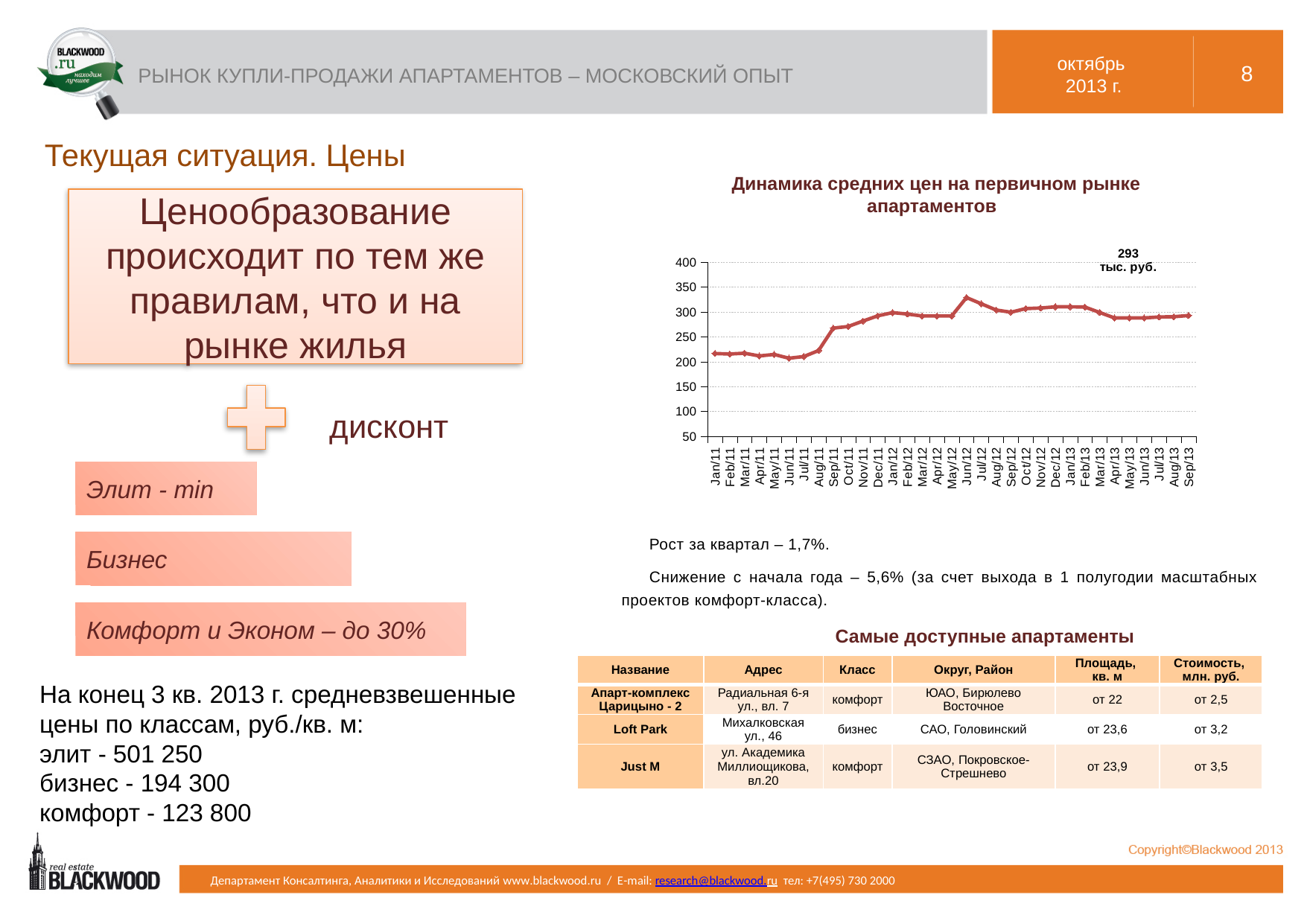
Do the values on the chart rise or fall overall from Jan/11 to Sep/13? rise What is the highest tick value shown on the vertical axis of the chart? 400 Which is larger, the value for Jan/11 or the value for Sep/13? Sep/13 Is the value for Jun/12 greater or less than 300? greater Which month has the highest value on the chart? Jun/12 What value is labelled on the chart for Sep/13? 293 тыс. руб. How many monthly points are plotted on the chart, from Jan/11 to Sep/13? 33 What is the title of the chart on the slide? Динамика средних цен на первичном рынке апартаментов What kind of chart is shown under the title "Динамика средних цен на первичном рынке апартаментов"? line chart Is the value for Jul/11 greater or less than 250? less Is the value for Jan/11 greater or less than 250? less Which is larger, the value for Jun/12 or the value for Sep/13? Jun/12